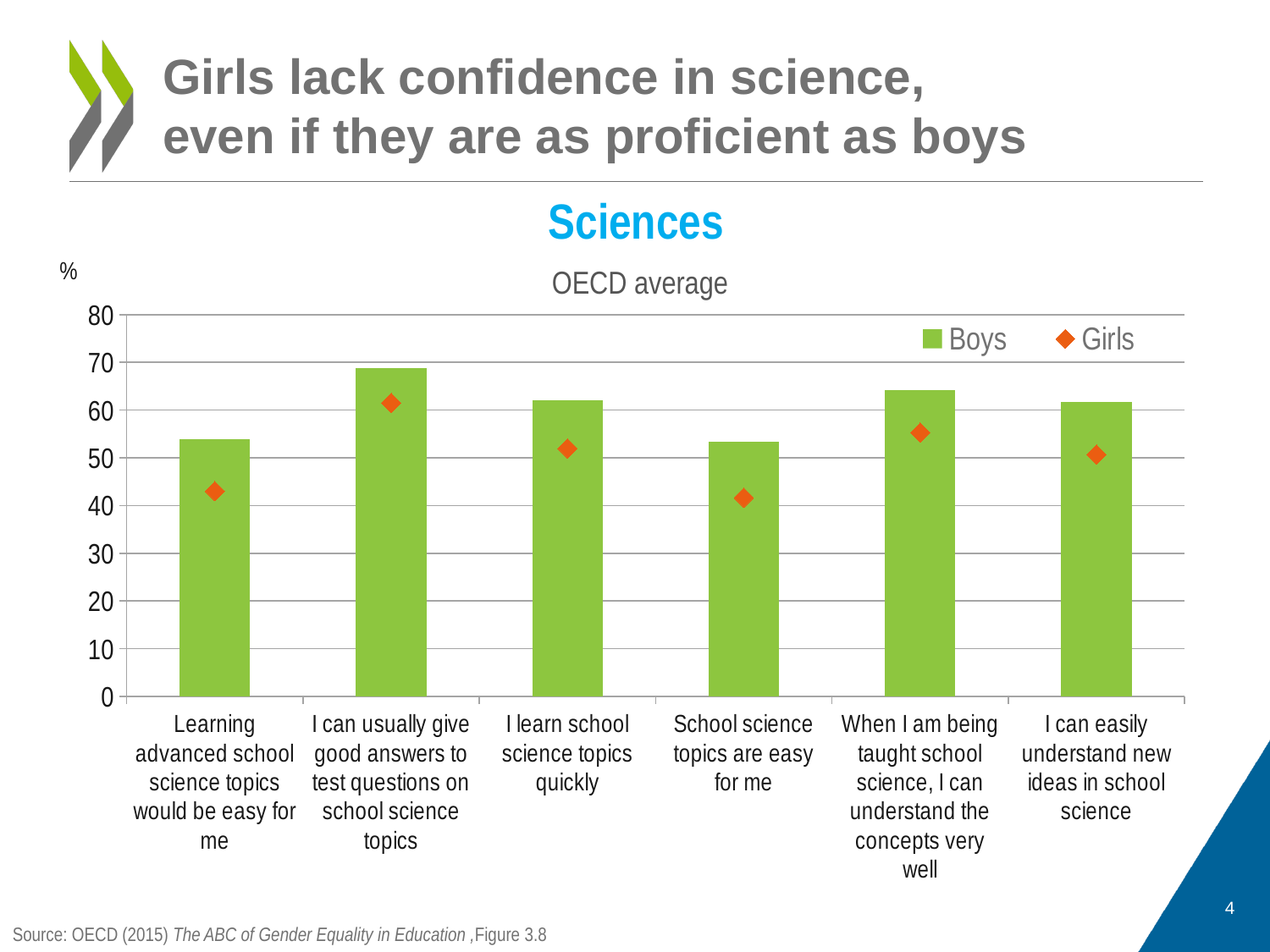
For which statement is the Boys value highest? I can usually give good answers to test questions on school science topics What kind of chart is used to show the Boys series? bar chart Is the Girls value for 'Learning advanced school science topics would be easy for me' greater or less than 50? less What is the title shown above the chart's plot area? OECD average How many series does the chart legend list? 2 For which statement is the Girls value highest? I can usually give good answers to test questions on school science topics Which is larger for Boys: 'I can usually give good answers to test questions on school science topics' or 'School science topics are easy for me'? I can usually give good answers to test questions on school science topics Is the Boys value for 'I can usually give good answers to test questions on school science topics' greater or less than 60? greater How many statement categories are shown on the x axis of the chart? 6 For 'Learning advanced school science topics would be easy for me', which is larger, the Boys value or the Girls value? Boys Is the Girls value for 'School science topics are easy for me' greater or less than 50? less